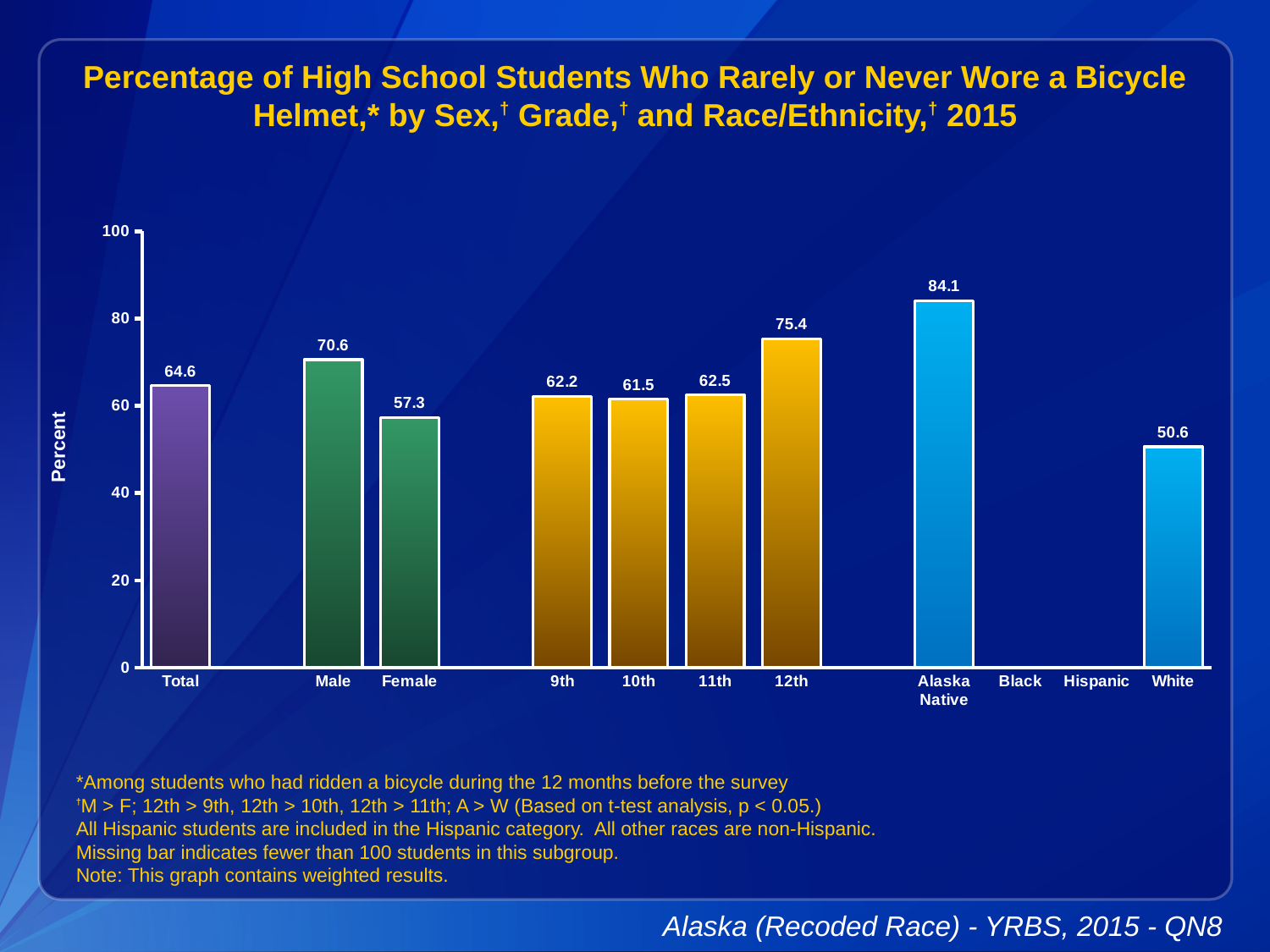
What kind of chart is shown? Bar chart What is the label of the y axis? Percent Which race/ethnicity categories have no bar plotted? Black and Hispanic Which category has the highest value? Alaska Native What is the difference between the Male and Female values? 13.3 Which category with a plotted bar has the lowest value? White How many bars are plotted on the chart? 9 Which is larger, the value for 9th grade or the value for 12th grade? 12th grade What is the value for Female? 57.3 What is the value for Alaska Native? 84.1 What is the value for 12th grade? 75.4 What is the value for Total? 64.6